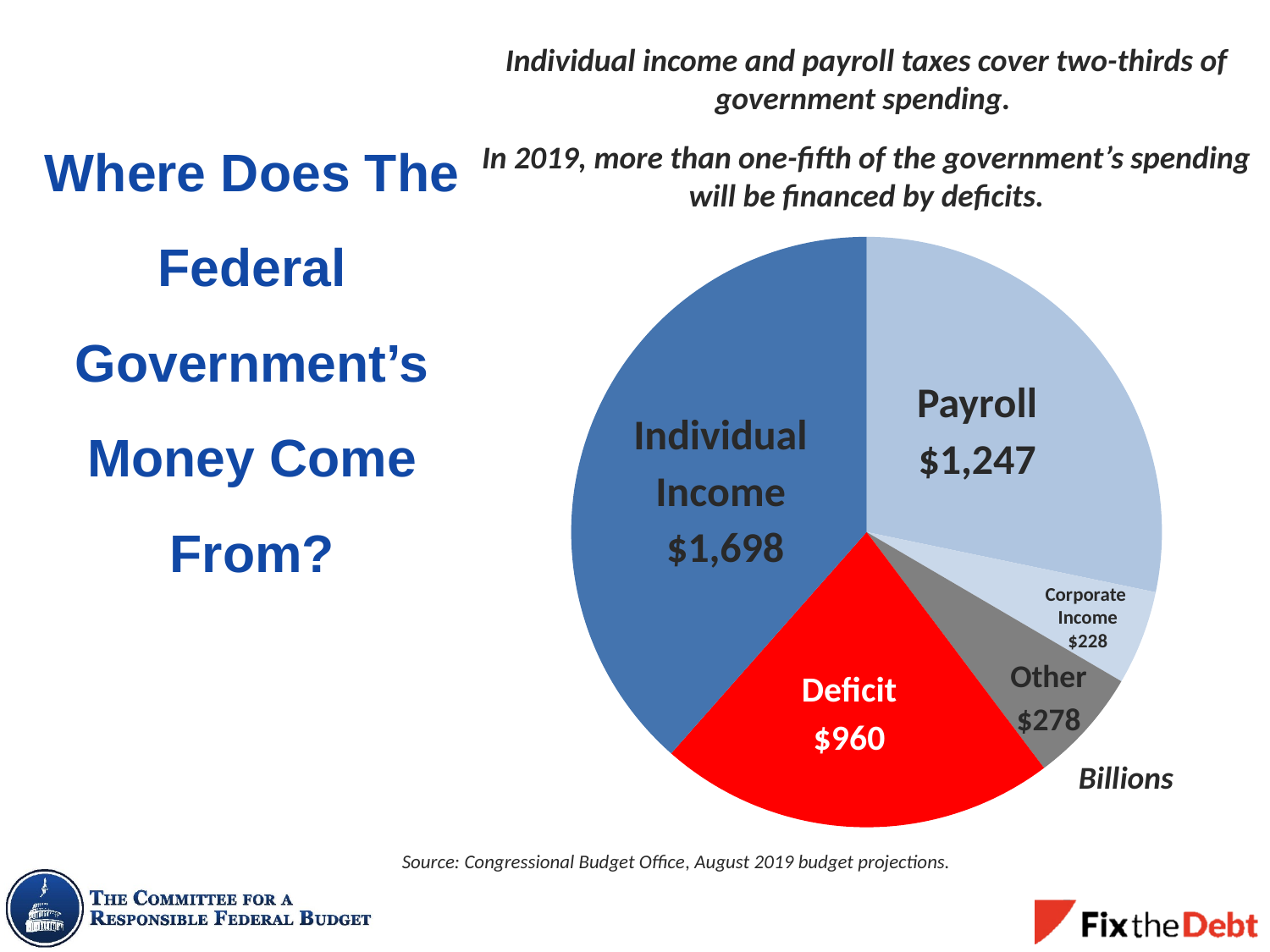
What is the value of the Payroll slice? $1,247 How many slices does the pie chart have? 5 What is the value of the Individual Income slice? $1,698 In what units are the values on the pie chart expressed? Billions Which slice of the pie chart is the largest? Individual Income What is the difference between the Individual Income and Payroll values? $451 What is the value of the Deficit slice? $960 What is the difference between the Other and Corporate Income values? $50 What is the value of the Corporate Income slice? $228 Which is larger, the Other slice or the Corporate Income slice? Other Which slice of the pie chart is the smallest? Corporate Income What kind of chart is shown on the slide? Pie chart